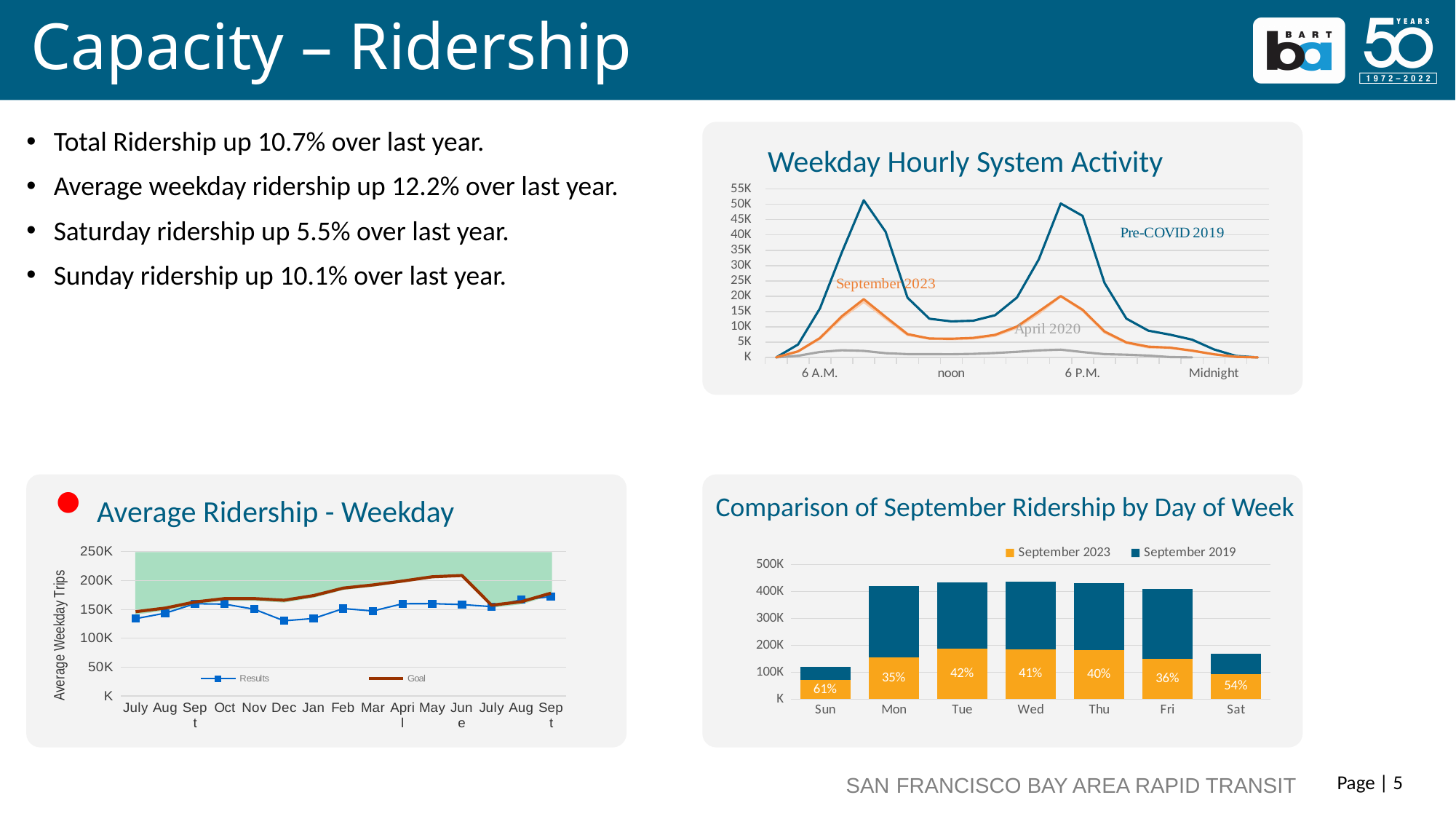
In the "Comparison of September Ridership by Day of Week" chart, how many days of the week are shown on the x axis? 7 In the "Comparison of September Ridership by Day of Week" chart, is the total stacked bar for Sun greater or less than 200K? less In the "Comparison of September Ridership by Day of Week" chart, is the total stacked bar for Wed greater or less than 400K? greater In the "Comparison of September Ridership by Day of Week" chart, what percentage label is shown on the Sun bar? 61% In the "Weekday Hourly System Activity" chart, is the peak of the Pre-COVID 2019 line greater or less than 45K? greater In the "Comparison of September Ridership by Day of Week" chart, how many series does the legend list? 2 What kind of chart is the "Comparison of September Ridership by Day of Week" chart? Stacked bar chart In the "Weekday Hourly System Activity" chart, which series is drawn in orange? September 2023 In the "Comparison of September Ridership by Day of Week" chart, what percentage label is shown on the Tue bar? 42% In the "Comparison of September Ridership by Day of Week" chart, which day has the highest percentage label? Sun In the "Comparison of September Ridership by Day of Week" chart, which day has the lowest percentage label? Mon